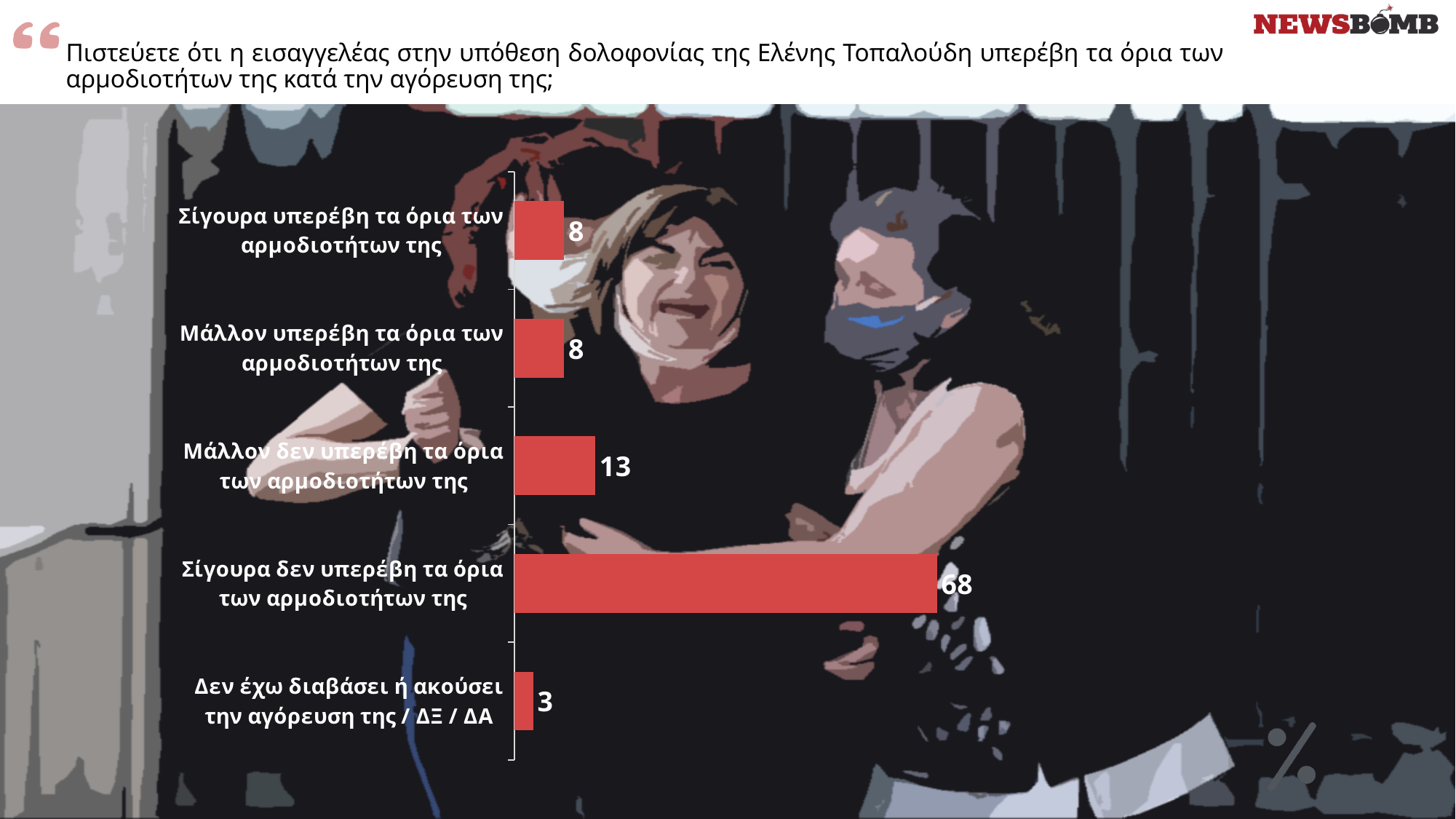
What is the difference between the values for "Μάλλον δεν υπερέβη τα όρια των αρμοδιοτήτων της" and "Μάλλον υπερέβη τα όρια των αρμοδιοτήτων της"? 5 What is the value for "Σίγουρα υπερέβη τα όρια των αρμοδιοτήτων της"? 8 Which category has the lowest value? Δεν έχω διαβάσει ή ακούσει την αγόρευση της / ΔΞ / ΔΑ Which is larger: the value for "Μάλλον δεν υπερέβη τα όρια των αρμοδιοτήτων της" or the value for "Σίγουρα υπερέβη τα όρια των αρμοδιοτήτων της"? Μάλλον δεν υπερέβη τα όρια των αρμοδιοτήτων της What is the value for "Σίγουρα δεν υπερέβη τα όρια των αρμοδιοτήτων της"? 68 How many categories does the chart show? 5 What is the value for "Δεν έχω διαβάσει ή ακούσει την αγόρευση της / ΔΞ / ΔΑ"? 3 What colour are the bars in the chart? Red What is the value for "Μάλλον δεν υπερέβη τα όρια των αρμοδιοτήτων της"? 13 What is the difference between the values for "Σίγουρα δεν υπερέβη τα όρια των αρμοδιοτήτων της" and "Μάλλον δεν υπερέβη τα όρια των αρμοδιοτήτων της"? 55 Which category has the highest value? Σίγουρα δεν υπερέβη τα όρια των αρμοδιοτήτων της What kind of chart is shown on the slide? Bar chart